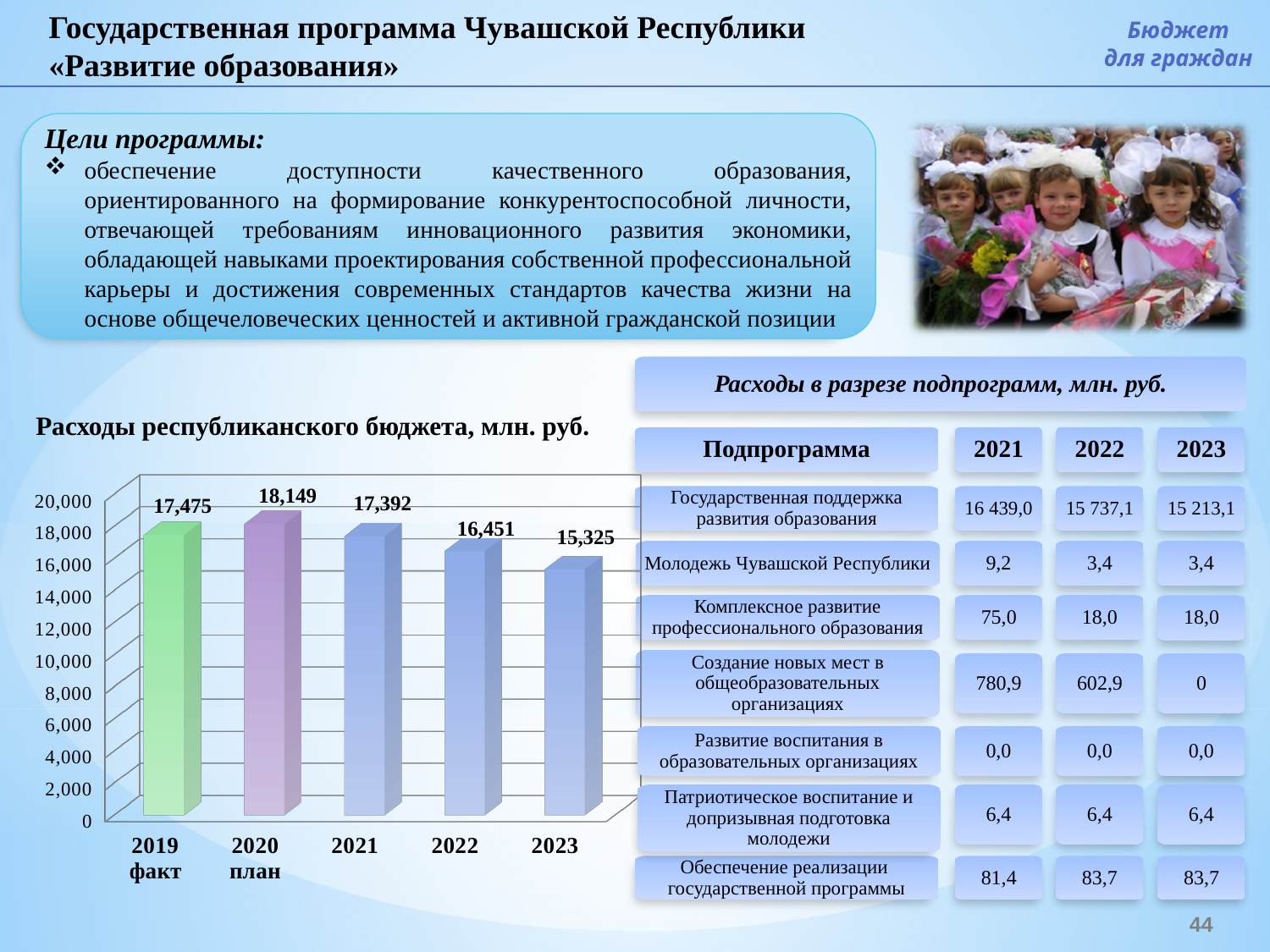
Is the value for 2022 greater or less than 16,000 in the chart "Расходы республиканского бюджета, млн. руб."? greater Do the values in the chart "Расходы республиканского бюджета, млн. руб." rise or fall from 2020 план to 2023? fall Which year has the lowest value in the chart "Расходы республиканского бюджета, млн. руб."? 2023 Which is larger in the chart "Расходы республиканского бюджета, млн. руб.": the value for 2019 факт or the value for 2021? 2019 факт What is the difference between the values for 2020 план and 2023 in the chart "Расходы республиканского бюджета, млн. руб."? 2,824 Which year has the highest value in the chart "Расходы республиканского бюджета, млн. руб."? 2020 план What is the value for 2019 факт in the chart "Расходы республиканского бюджета, млн. руб."? 17,475 How many bars are shown in the chart "Расходы республиканского бюджета, млн. руб."? 5 What kind of chart is "Расходы республиканского бюджета, млн. руб."? bar chart What is the value for 2020 план in the chart "Расходы республиканского бюджета, млн. руб."? 18,149 What is the value for 2023 in the chart "Расходы республиканского бюджета, млн. руб."? 15,325 What is the difference between the values for 2021 and 2022 in the chart "Расходы республиканского бюджета, млн. руб."? 941